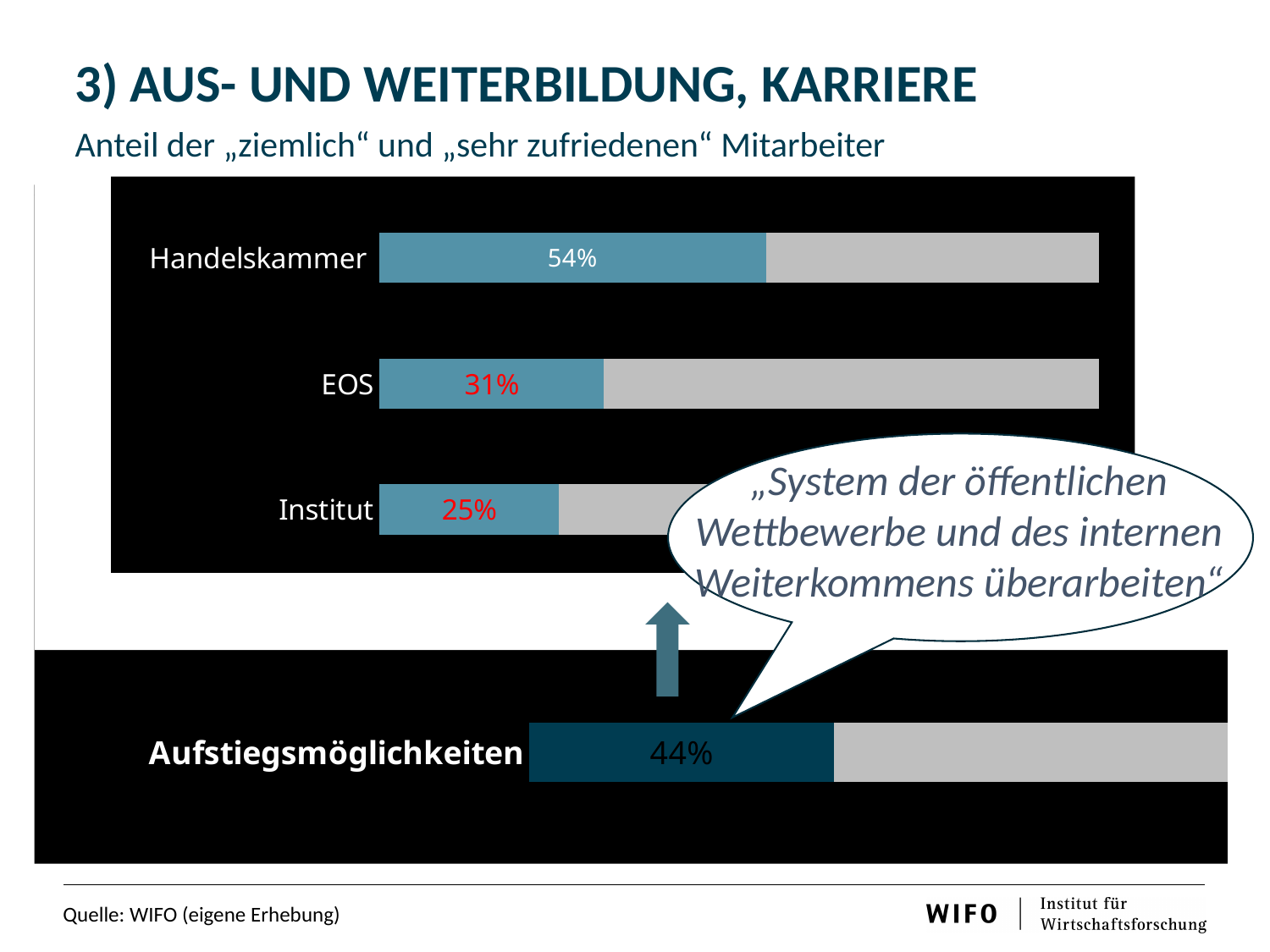
What kind of chart is the upper chart? bar chart In the upper chart, what is the value for Handelskammer? 54% In the upper chart, what is the difference between the values for Handelskammer and Institut? 29% In the upper chart, which values are printed in red? 31% and 25% In the upper chart, which category has the highest value? Handelskammer In the upper chart, what is the difference between the values for EOS and Institut? 6% In the upper chart, which is larger, the value for EOS or the value for Institut? EOS In the upper chart, what is the value for Institut? 25% In the lower chart, what is the value for Aufstiegsmöglichkeiten? 44% In the upper chart, which category has the lowest value? Institut How many categories does the upper chart show? 3 In the upper chart, what is the value for EOS? 31%